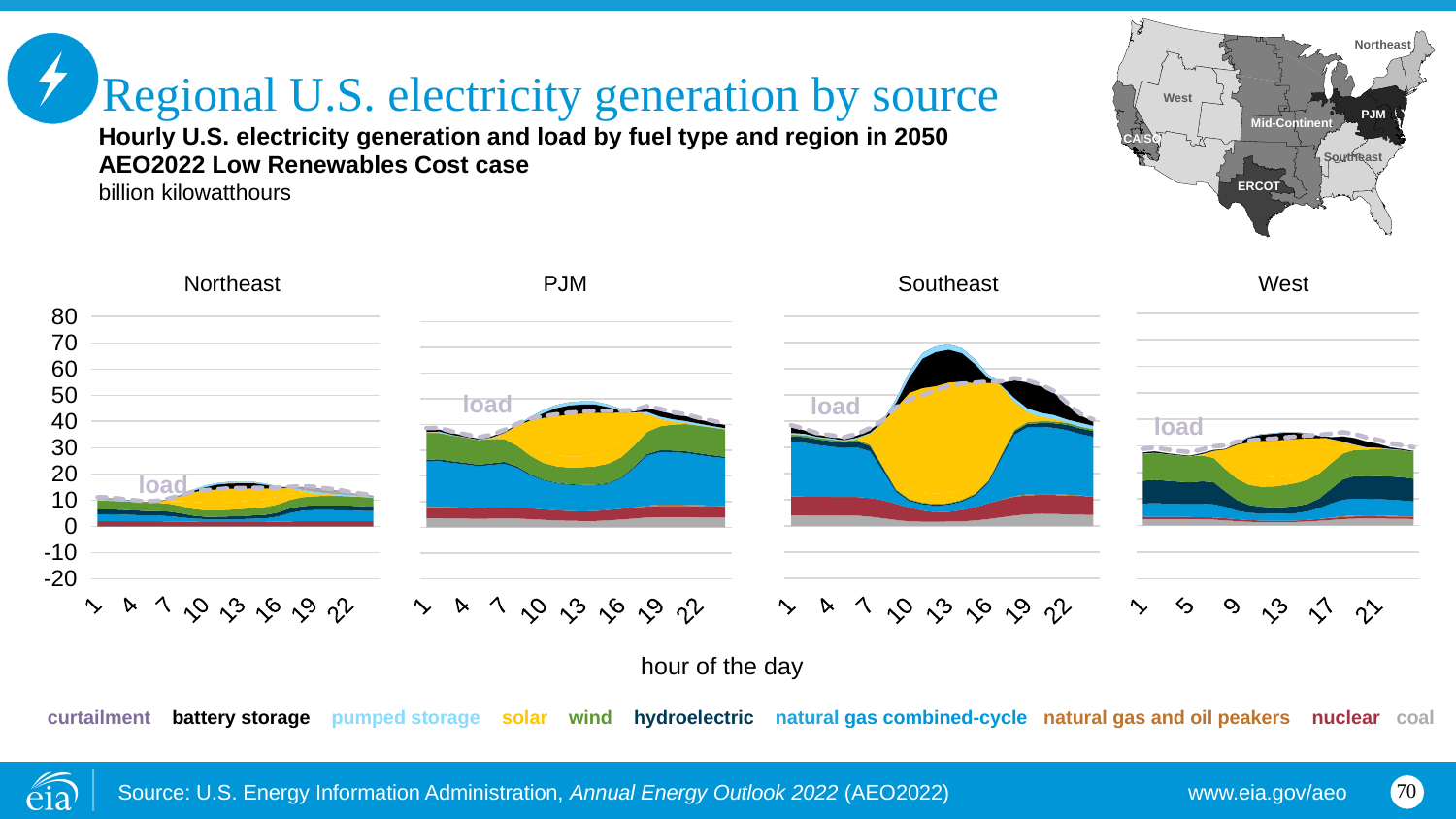
What label is given to the x axis shared by the four charts? hour of the day In the Southeast chart, is the peak hourly generation greater or less than 50? greater How many regional charts are shown on the slide? 4 In the Southeast chart, does total generation rise or fall from hour 7 to hour 13? rise How many fuel-type series does the legend at the bottom of the slide list? 10 In what unit are the values on the charts expressed? billion kilowatthours Which region's chart shows the lowest hourly generation overall? Northeast What kind of chart is used for each region on the slide? stacked area chart Which region's chart shows the highest peak hourly generation? Southeast In the West chart, is the peak hourly generation greater or less than 50? less Which region has a higher peak hourly generation, PJM or West? PJM In the Northeast chart, is the peak load greater or less than 20? less